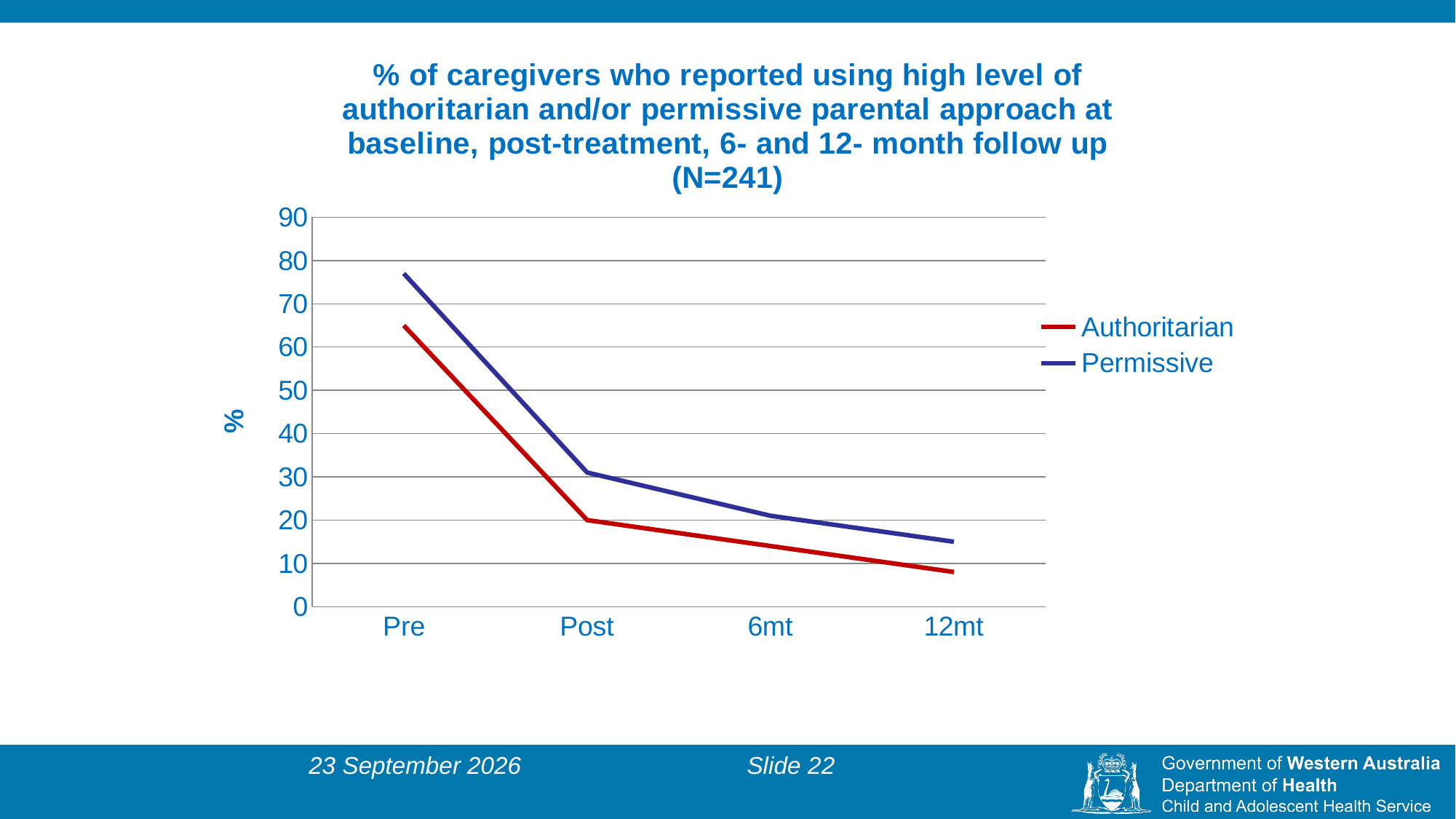
How many series does the legend list? 2 What kind of chart is shown on the slide? line chart At which time point is the Authoritarian series highest? Pre Which series is shown in red in the legend? Authoritarian Do the values for the Permissive series rise or fall from Pre to 12mt? fall At which time point is the Permissive series lowest? 12mt Is the value for Authoritarian at 12mt greater or less than 10? less What is the label on the vertical axis? % Is the value for Authoritarian at Pre greater or less than 60? greater At Pre, which series has the higher value, Authoritarian or Permissive? Permissive How many time points are plotted along the x axis? 4 Is the value for Permissive at Pre greater or less than 70? greater